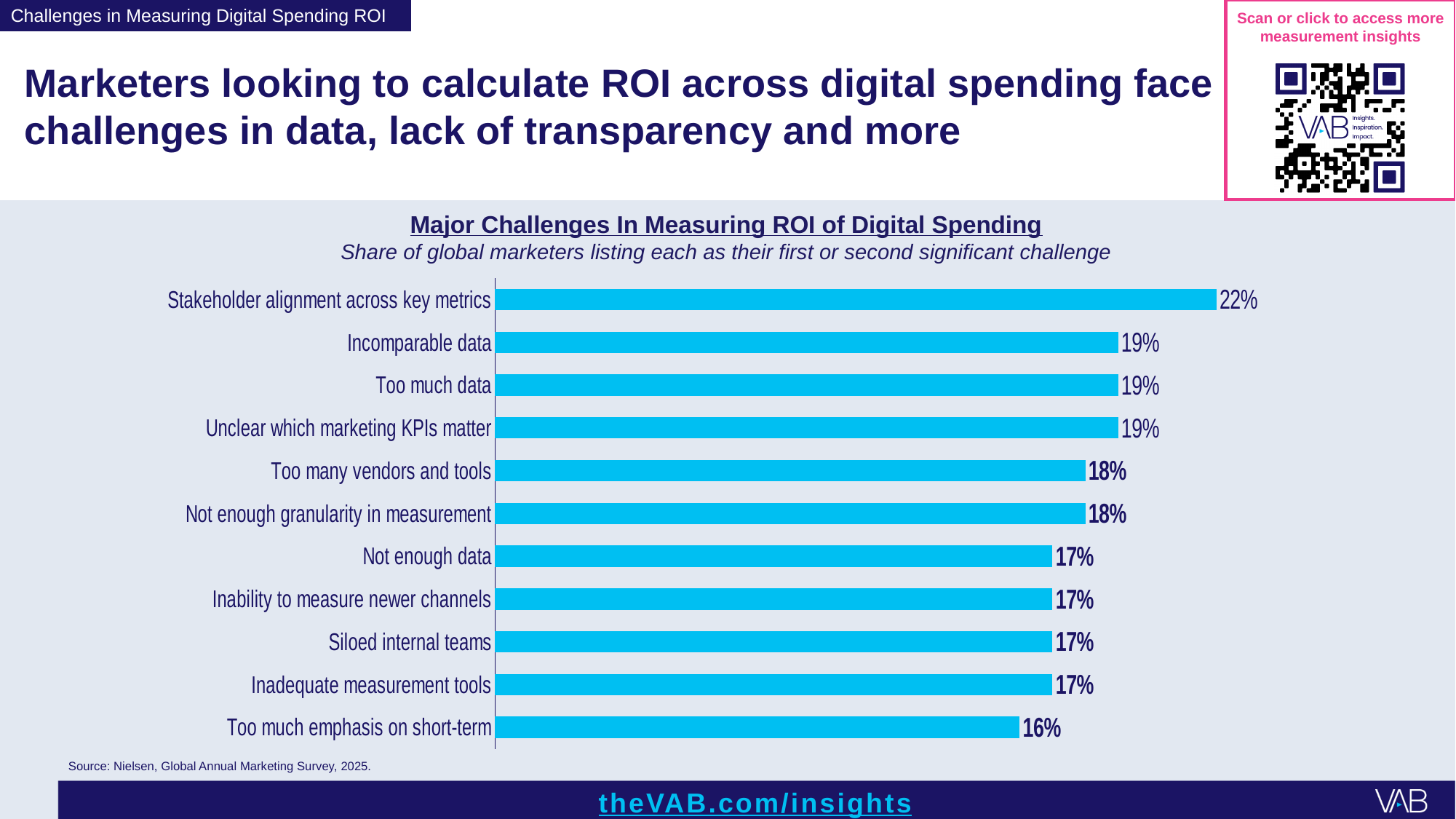
What share of marketers listed Stakeholder alignment across key metrics as a significant challenge? 22% What is the value shown for Too much emphasis on short-term? 16% What is the value shown for Too many vendors and tools? 18% What is the difference between the values for Stakeholder alignment across key metrics and Too much emphasis on short-term? 6% How many challenges are plotted in the chart? 11 Which challenge has the highest share of marketers? Stakeholder alignment across key metrics What kind of chart is shown on the slide? Bar chart What is the value shown for Siloed internal teams? 17% Which is larger, the value for Unclear which marketing KPIs matter or the value for Inadequate measurement tools? Unclear which marketing KPIs matter Which challenge has the lowest share of marketers? Too much emphasis on short-term What is the difference between the values for Incomparable data and Not enough data? 2% What is the title of the chart? Major Challenges In Measuring ROI of Digital Spending